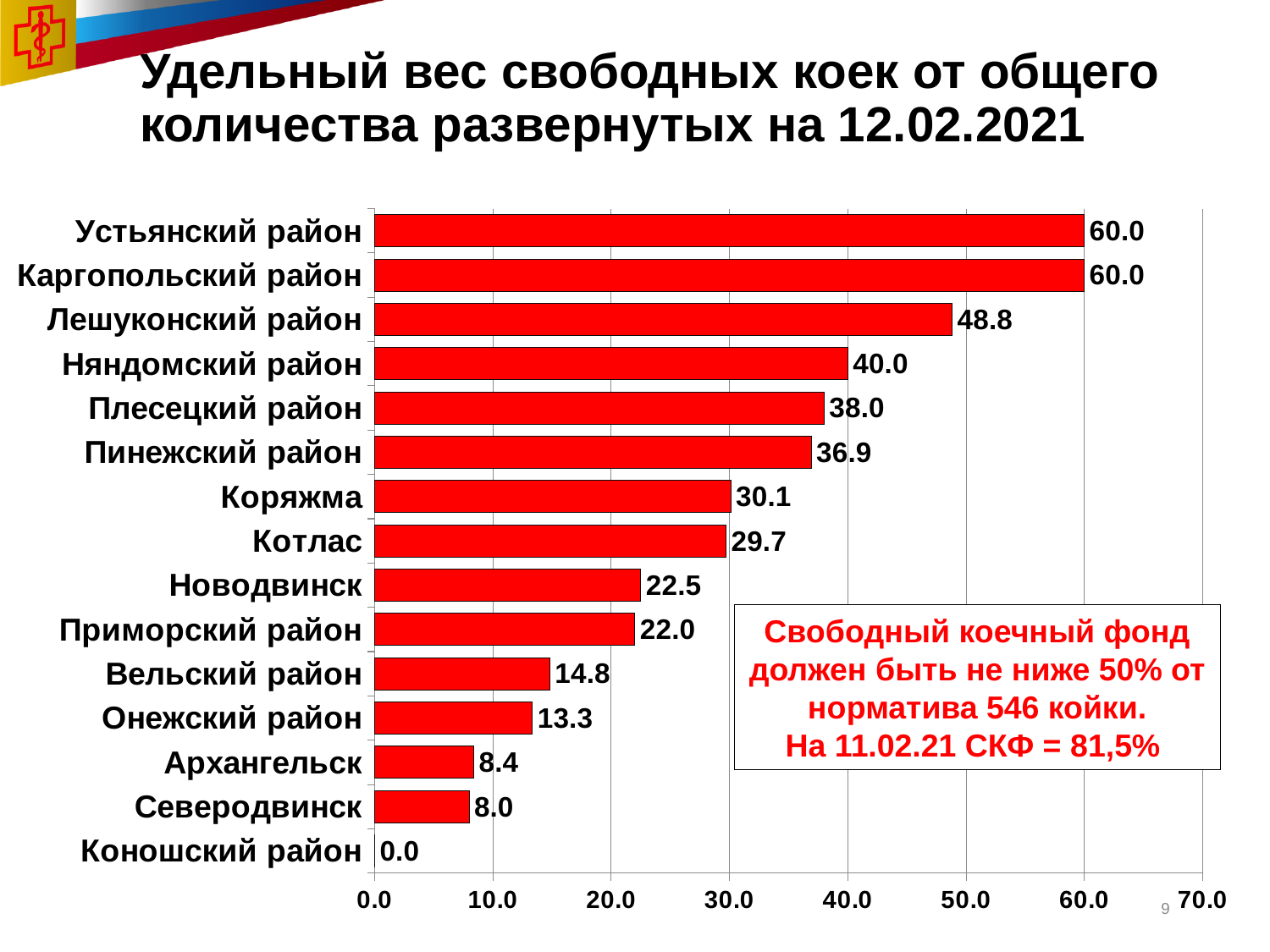
How many categories are shown on the chart? 15 Is the value for Пинежский район greater or less than 30.0? greater What colour are the bars in the chart? red What is the value for Котлас? 29.7 Which is larger, the value for Новодвинск or the value for Вельский район? Новодвинск What kind of chart is shown on the slide? bar chart What is the difference between the values for Устьянский район and Архангельск? 51.6 Which category has the lowest value? Коношский район What is the value for Северодвинск? 8.0 What is the difference between the values for Няндомский район and Плесецкий район? 2.0 What is the highest value shown on the x axis? 70.0 What is the value for Лешуконский район? 48.8